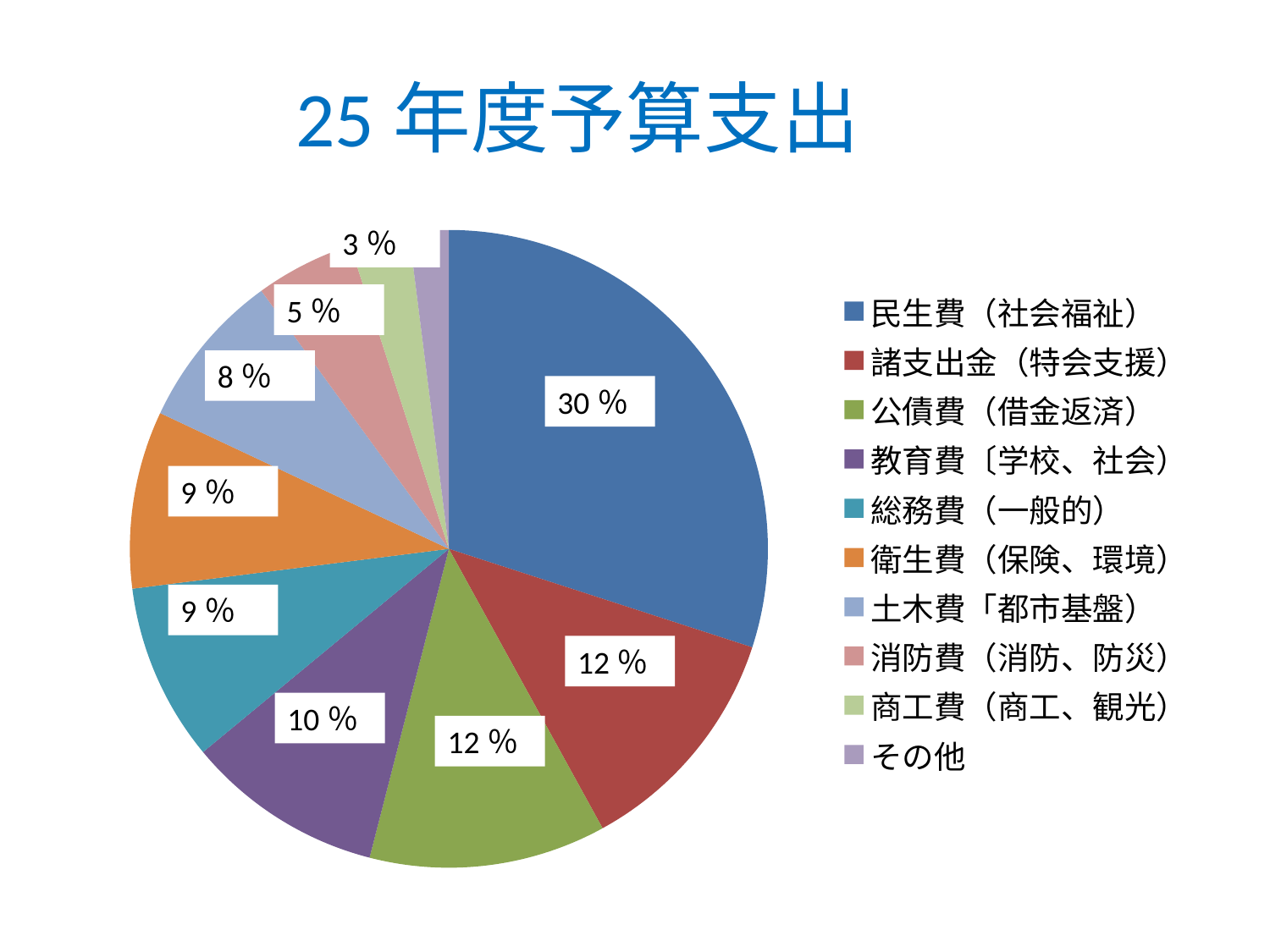
What share of the pie is 商工費（商工、観光）? 3 % How many categories does the legend list? 10 What share of the pie is 消防費（消防、防災）? 5 % What share of the pie is 教育費〔学校、社会〕? 10 % What kind of chart is shown on the slide? pie chart What colour is the slice for 衛生費（保険、環境）? orange Which category has the largest share of the pie? 民生費（社会福祉） What is the title of the chart? 25 年度予算支出 Which has the larger share, 教育費〔学校、社会〕 or 消防費（消防、防災）? 教育費〔学校、社会〕 What share of the pie is 土木費「都市基盤」? 8 % What share of the pie is 民生費（社会福祉）? 30 % What is the difference between the share of 民生費（社会福祉） and the share of 諸支出金（特会支援）? 18 %